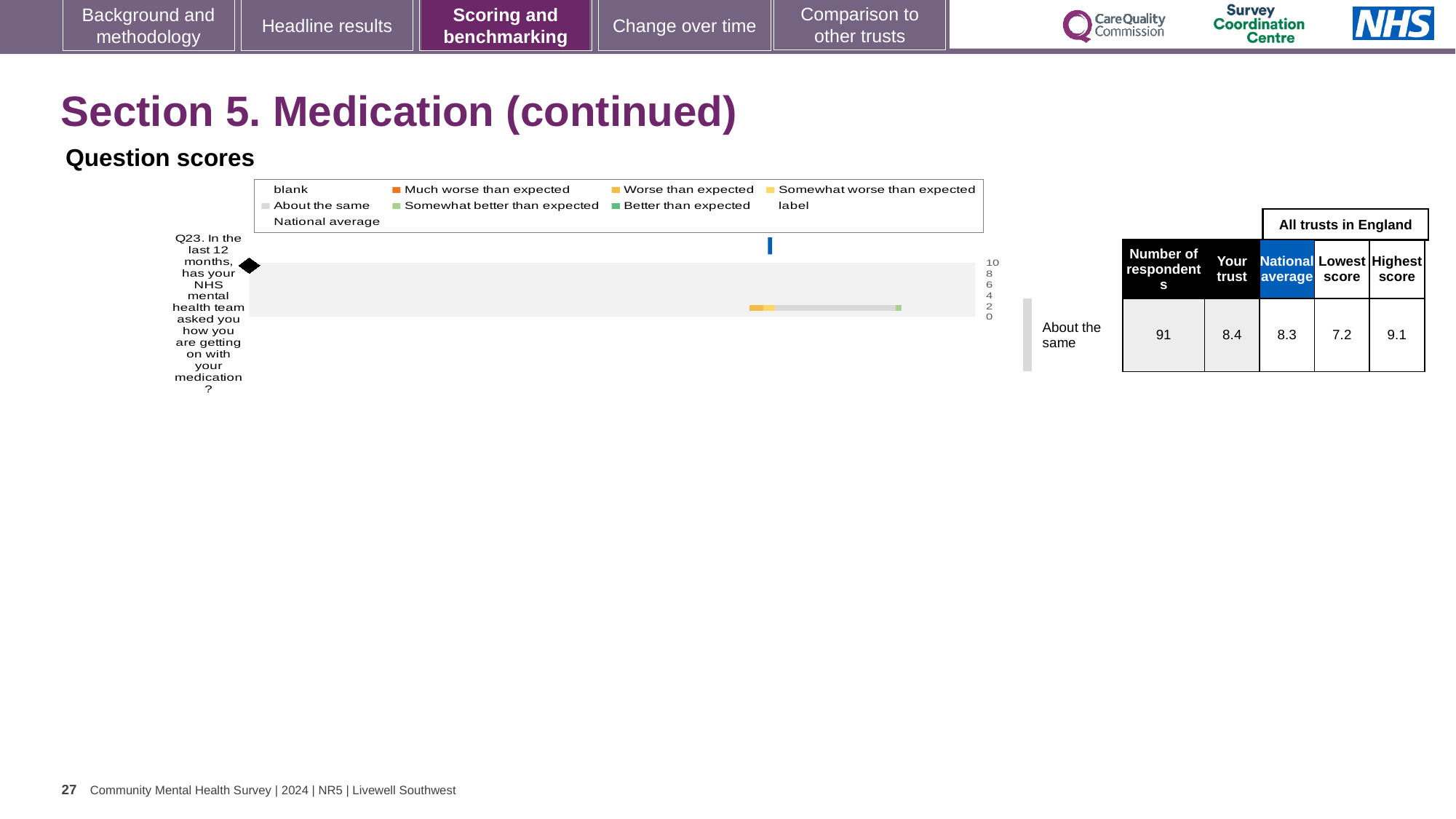
What is the difference between the highest and lowest scores for Q23 across all trusts in England? 1.9 What is the national average score for Q23? 8.3 Which is larger for Q23, the 'Your trust' score or the national average? Your trust What is the highest score among all trusts in England for Q23? 9.1 What kind of chart is shown under 'Question scores'? bar chart How many respondents answered Q23? 91 What is the lowest score among all trusts in England for Q23? 7.2 What benchmark category is shown for Q23 next to the chart? About the same What is the 'Your trust' score for Q23? 8.4 Which question number is plotted in the 'Question scores' chart? Q23 What colour does the legend use for 'Much worse than expected'? orange How many survey questions are plotted in the 'Question scores' chart? 1